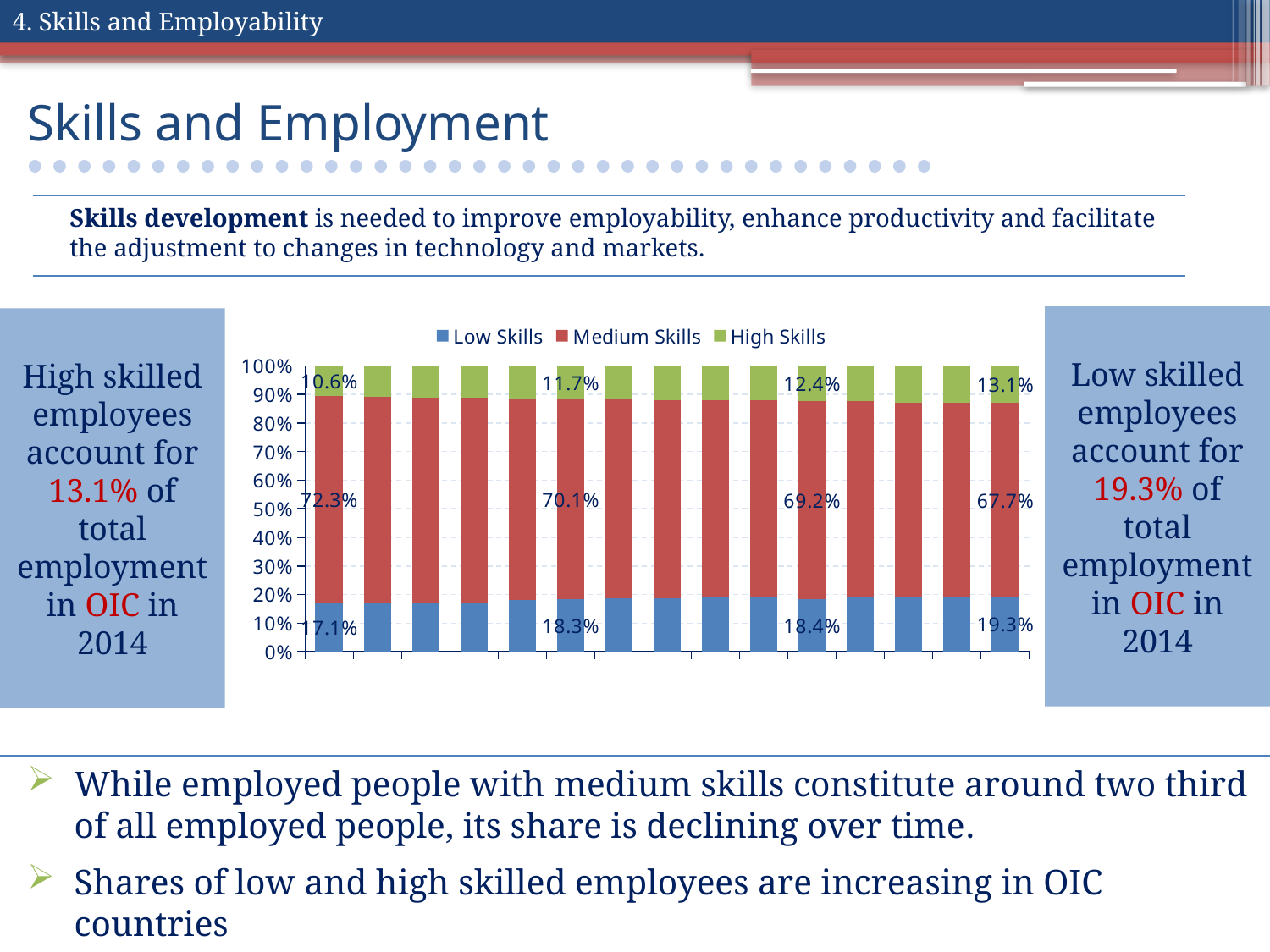
What is the Low Skills share shown on the last (rightmost) bar? 19.3% Does the Medium Skills share rise or fall from the left of the chart to the right? Fall By how many percentage points did the Low Skills share increase from the first bar (17.1%) to the last bar (19.3%)? 2.2 percentage points What kind of chart is shown on the slide? Stacked bar chart What are the three series named in the chart legend? Low Skills, Medium Skills, High Skills Which series has the largest share in the last (rightmost) bar? Medium Skills By how many percentage points does the Medium Skills share on the first bar exceed the Medium Skills share on the last bar? 4.6 percentage points How many series does the chart legend list? 3 What is the Medium Skills share shown on the first (leftmost) bar? 72.3% What is the High Skills share shown on the last (rightmost) bar? 13.1% On the first bar, which is larger: the Low Skills share or the High Skills share? Low Skills What is the High Skills share shown on the first (leftmost) bar? 10.6%